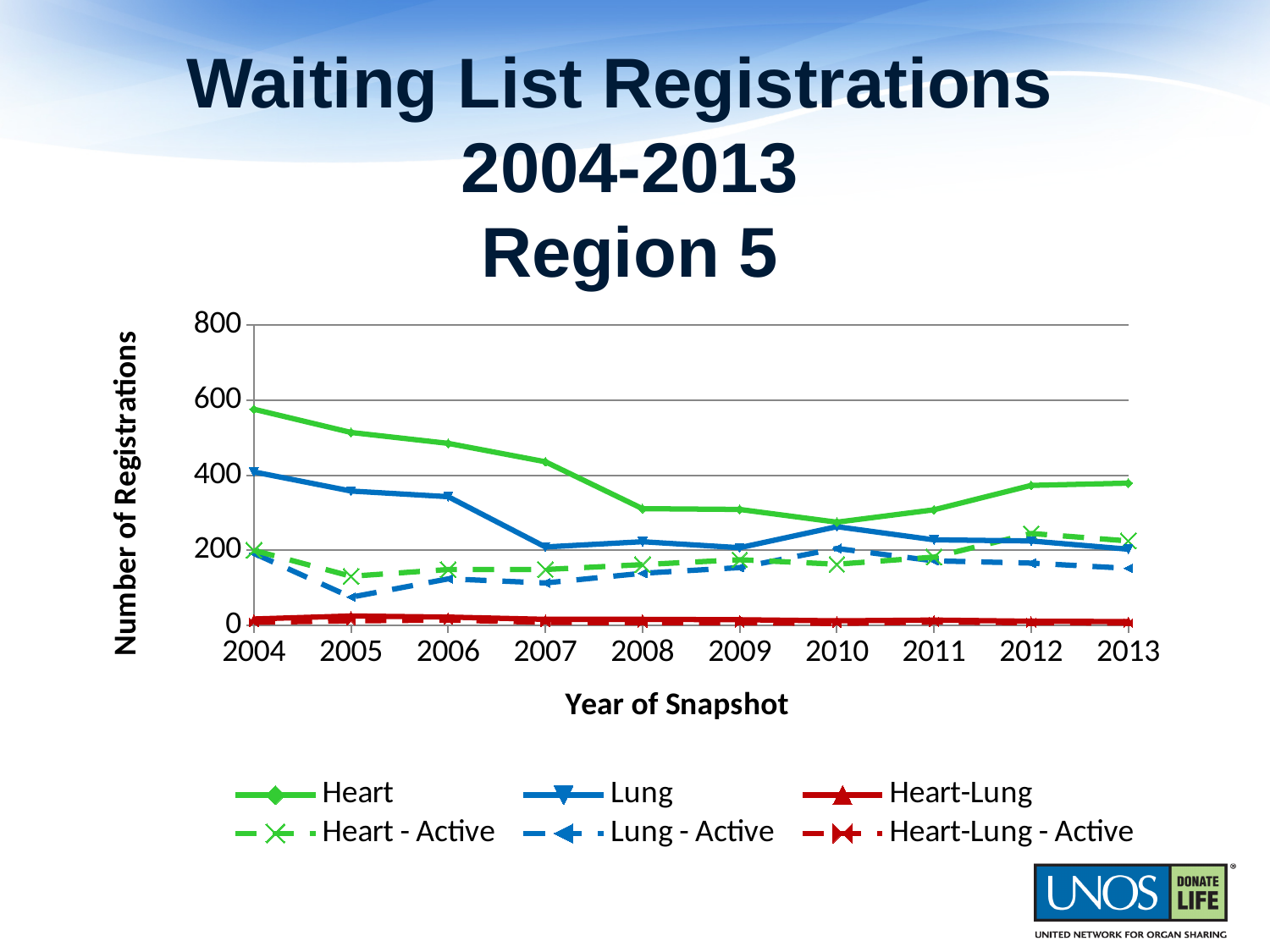
How many years are plotted along the x axis? 10 Does the Heart series rise or fall from 2004 to 2010? fall Is the value for Heart in 2004 greater or less than 400? greater Which is larger in 2004, the Heart value or the Lung value? Heart In which year is the Heart series at its highest? 2004 How many series does the legend list? 6 Is the value for Lung in 2005 greater or less than 400? less Is the value for Heart-Lung in 2008 greater or less than 200? less What kind of chart is shown on the slide? line chart What is the title of the y axis? Number of Registrations In which year is the Lung series at its highest? 2004